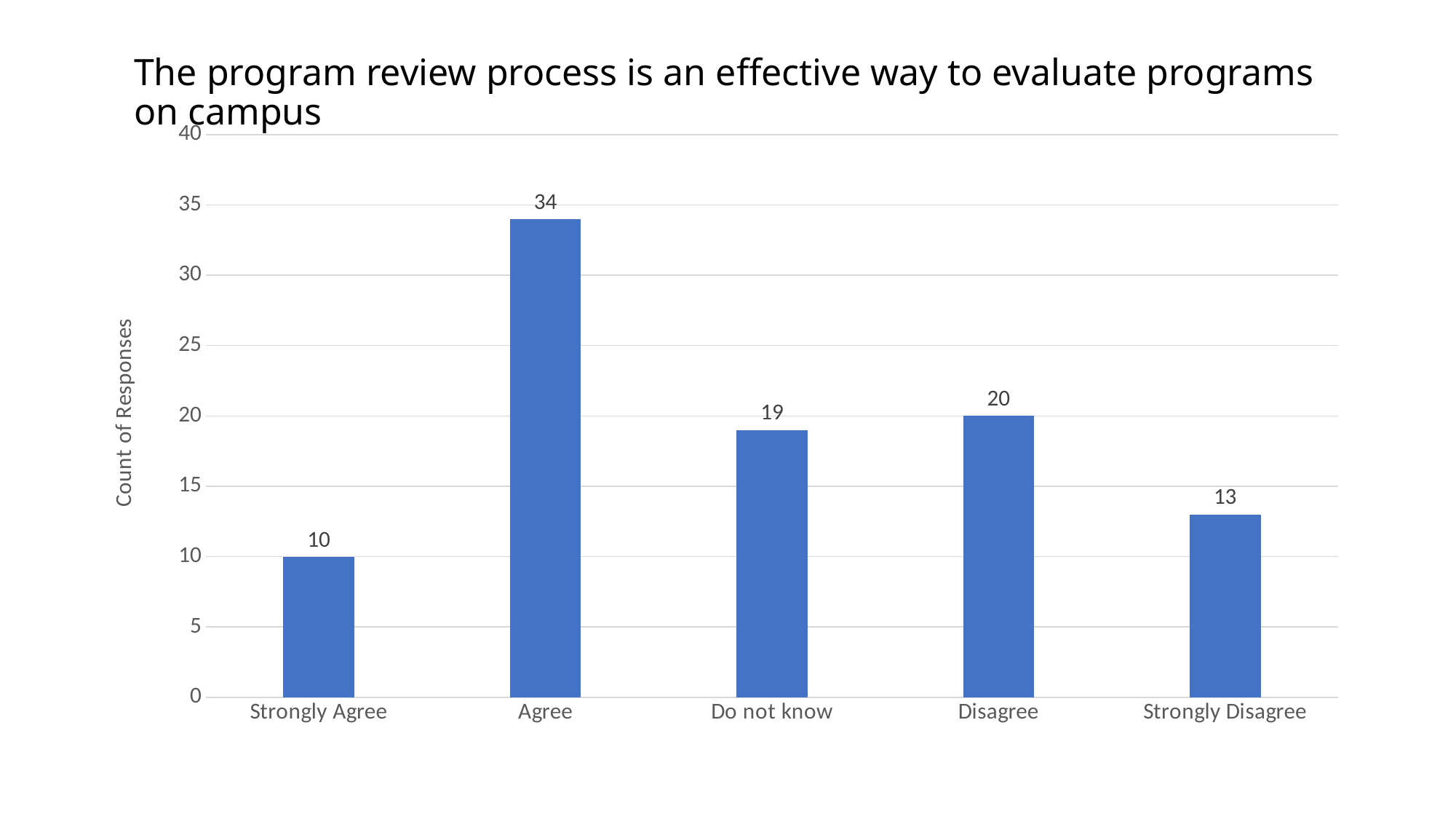
What is the count of responses for Do not know? 19 What is the count of responses for Agree? 34 How many response categories are shown on the x axis? 5 What kind of chart is shown on the slide? Bar chart Which response category has the highest count? Agree Is the value for Agree greater or less than 30? greater What is the count of responses for Strongly Disagree? 13 What is the label of the vertical axis? Count of Responses Which response category has the lowest count? Strongly Agree What is the difference between the counts for Agree and Disagree? 14 What is the total count of responses across all five categories? 96 Which has a higher count, Disagree or Strongly Disagree? Disagree